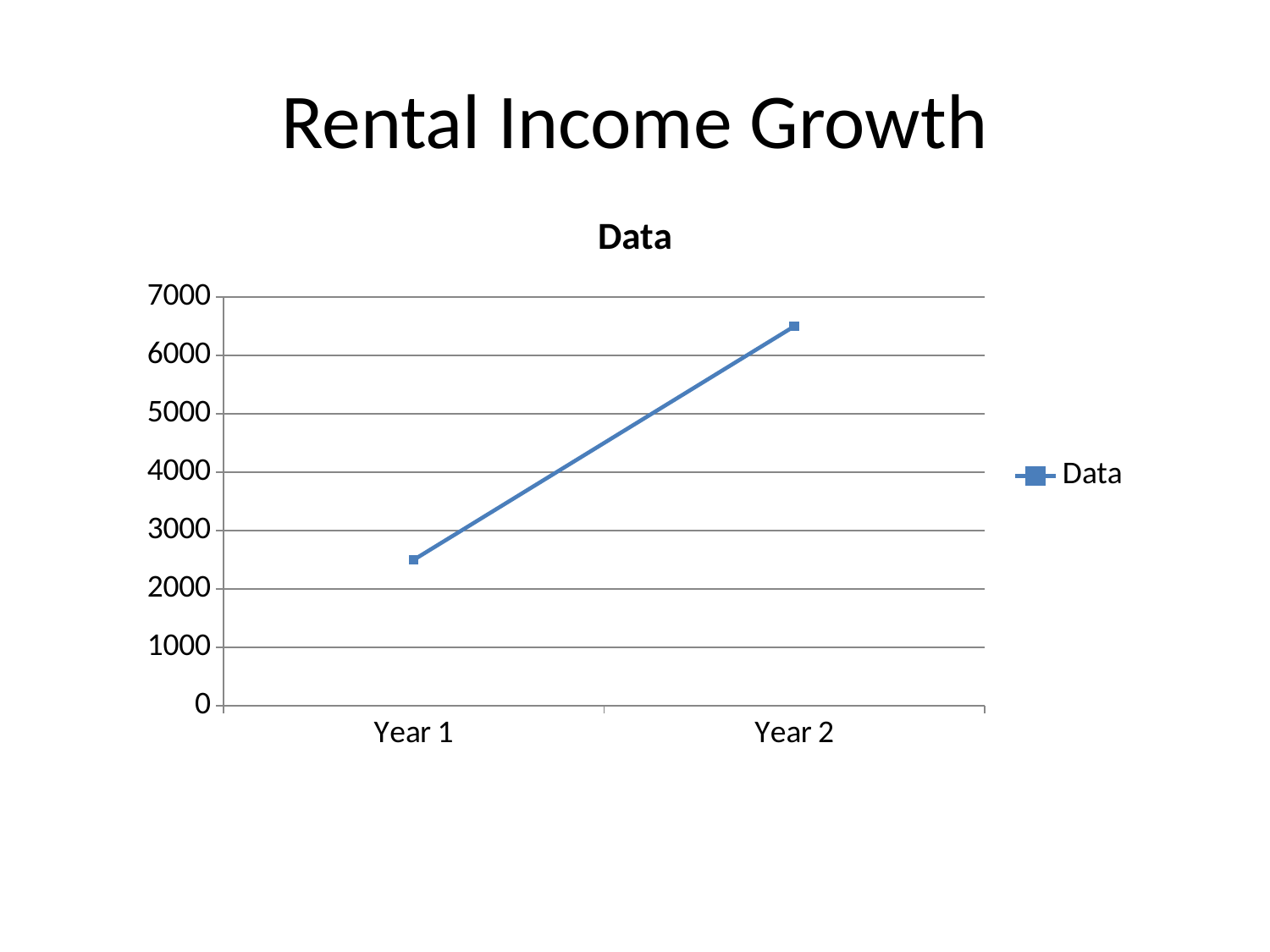
Is the value for Year 1 greater or less than 2000? greater Which is larger, the value for Year 1 or the value for Year 2? Year 2 Is the value for Year 1 greater or less than 3000? less What kind of chart is shown on the slide? line chart Is the value for Year 2 greater or less than 6000? greater How many categories are plotted along the x axis? 2 What is the title of the chart? Data Which year has the highest value? Year 2 How many series does the legend list? 1 Which year has the lowest value? Year 1 Do the values rise or fall from Year 1 to Year 2? rise